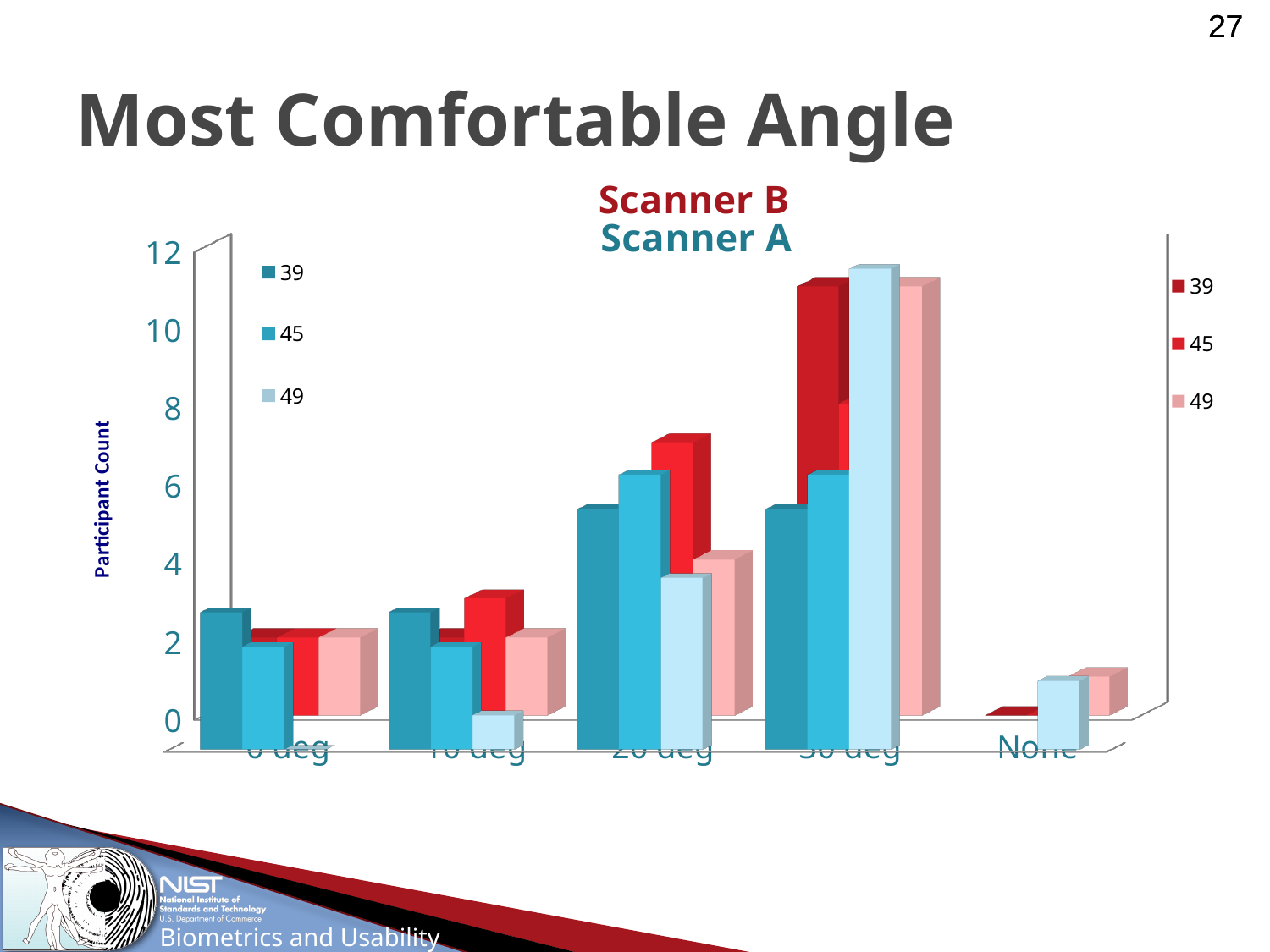
For Scanner A series 49, which angle category has the highest participant count? 30 deg Is the Scanner B series 45 value for 20 deg greater or less than 4? greater What is the title of the y axis? Participant Count For Scanner B series 39, which angle category has the highest participant count? 30 deg For Scanner A series 49, which is larger: the value for 20 deg or the value for 30 deg? 30 deg How many series does the Scanner A legend list? 3 What kind of chart is shown on the slide? bar chart How many series does the Scanner B legend list? 3 How many angle categories are shown along the x axis? 5 Is the Scanner A series 49 value for 30 deg greater or less than 8? greater Is the Scanner A series 39 value for 0 deg greater or less than 6? less